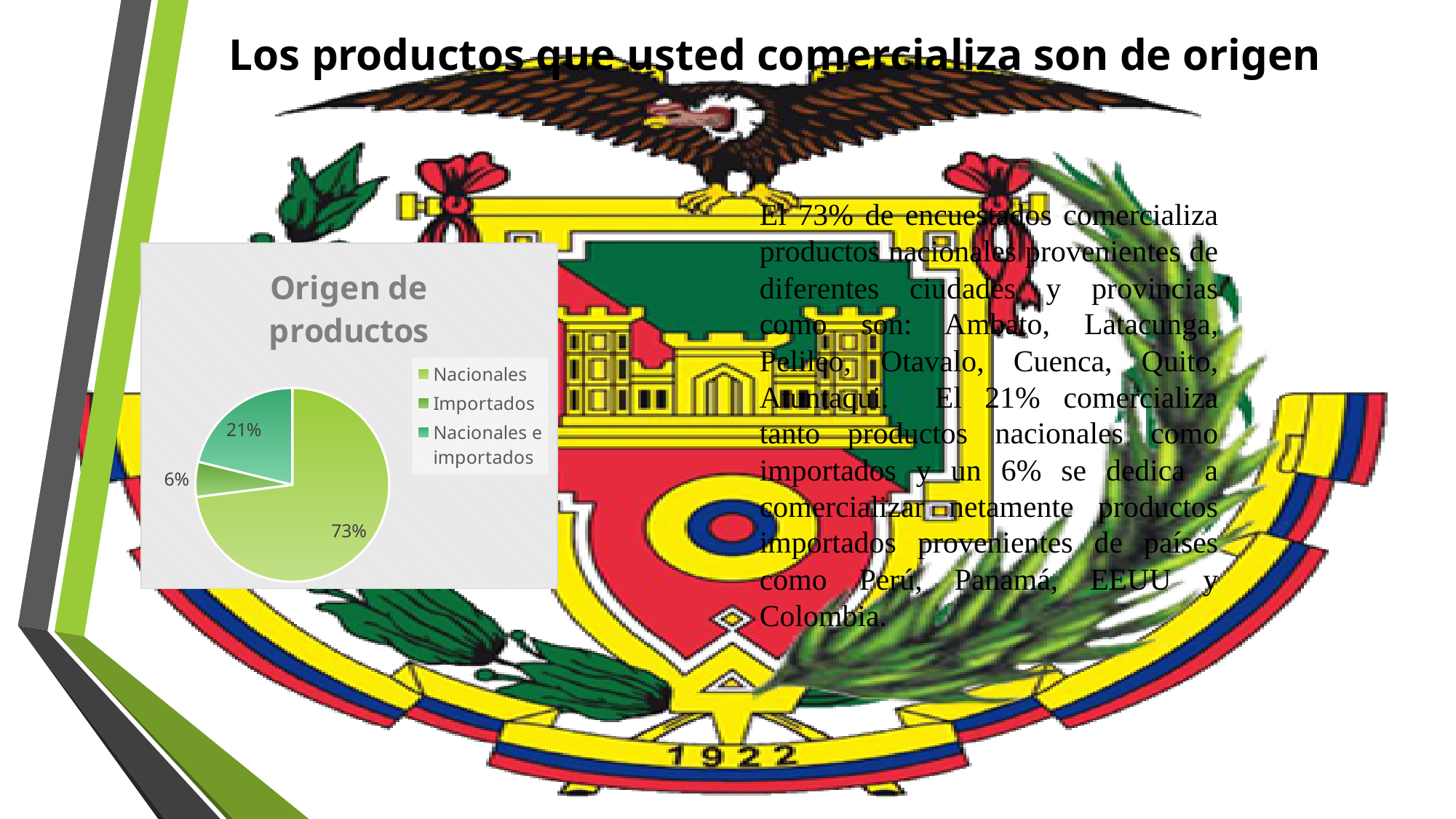
What percentage of the pie is Nacionales? 73% What percentage of the pie is Importados? 6% What is the title of the chart? Origen de productos How many entries does the legend list? 3 How many categories does the pie chart show? 3 Which is larger, the share for Importados or the share for Nacionales e importados? Nacionales e importados What is the difference between the Nacionales share and the Nacionales e importados share? 52% What type of chart is shown on the slide? pie chart Which category has the largest share of the pie? Nacionales What is the difference between the Nacionales e importados share and the Importados share? 15% Which category has the smallest share of the pie? Importados What percentage of the pie is Nacionales e importados? 21%